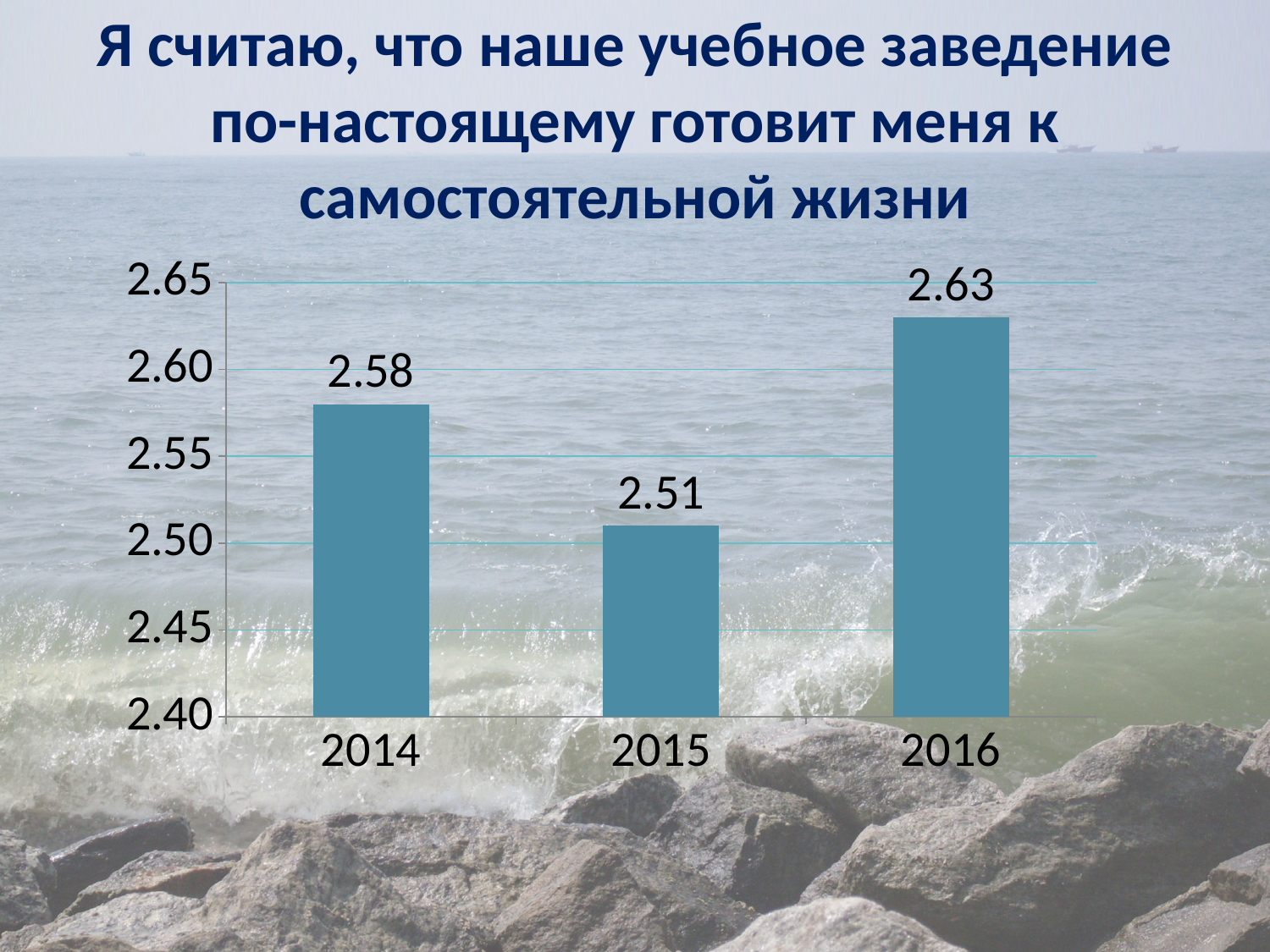
What kind of chart is shown on the slide? bar chart Which year has the highest value? 2016 What is the value for 2015? 2.51 What is the value for 2014? 2.58 Which is larger, the value for 2014 or the value for 2016? 2016 Which year has the lowest value? 2015 What is the difference between the values for 2014 and 2015? 0.07 Is the value for 2015 greater or less than 2.55? less What is the value for 2016? 2.63 Does the value rise or fall from 2015 to 2016? rise How many years are shown on the chart? 3 What is the difference between the values for 2016 and 2015? 0.12